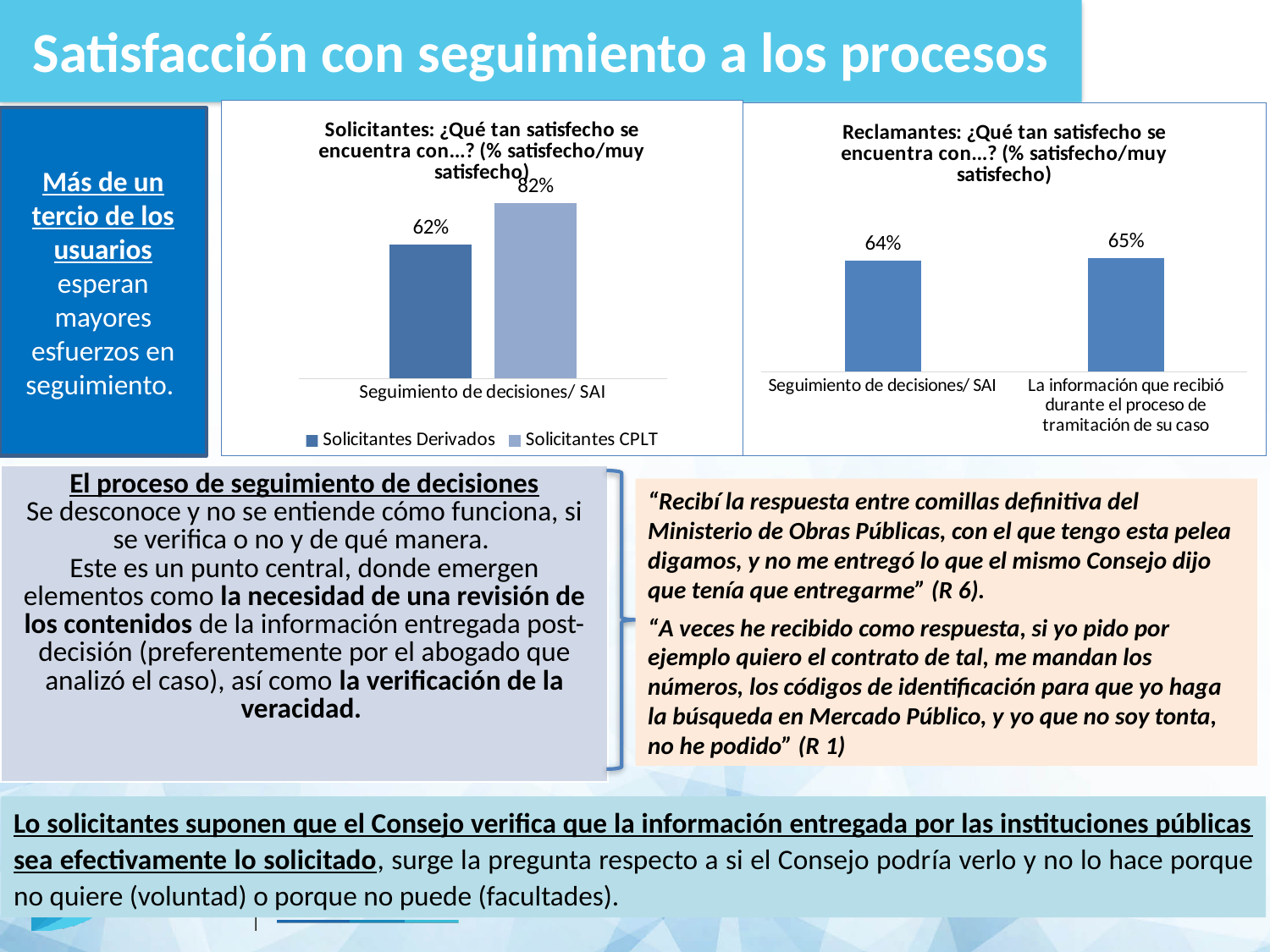
In the right chart (Reclamantes), what is the difference between the two plotted values? 1% In the left chart (Solicitantes), what is the value for Solicitantes Derivados for Seguimiento de decisiones/ SAI? 62% In the left chart (Solicitantes), which series has the higher value: Solicitantes Derivados or Solicitantes CPLT? Solicitantes CPLT What type of chart is the right chart (Reclamantes)? Bar chart What are the two legend entries of the left chart (Solicitantes)? Solicitantes Derivados and Solicitantes CPLT How many categories are shown in the right chart (Reclamantes)? 2 In the right chart (Reclamantes), what is the value for La información que recibió durante el proceso de tramitación de su caso? 65% In the right chart (Reclamantes), what is the value for Seguimiento de decisiones/ SAI? 64% How many series does the legend of the left chart (Solicitantes) list? 2 In the left chart (Solicitantes), what is the value for Solicitantes CPLT for Seguimiento de decisiones/ SAI? 82% In the left chart (Solicitantes), what is the difference between the Solicitantes CPLT value and the Solicitantes Derivados value? 20% What type of chart is the left chart (Solicitantes)? Bar chart